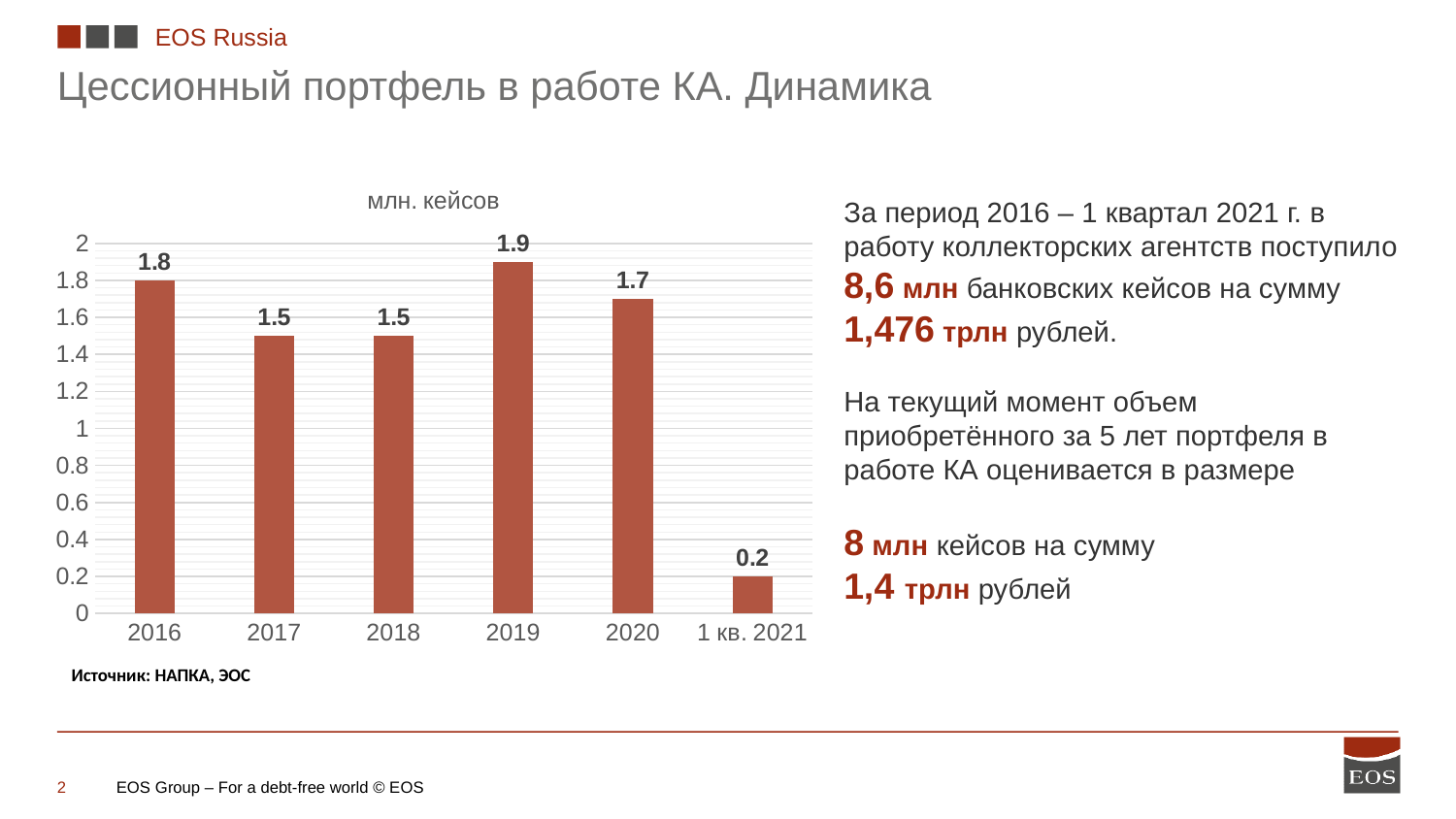
Is the value for 2020 greater or less than 1? greater Which category has the lowest value? 1 кв. 2021 How many categories are shown on the x axis? 6 What is the title of the chart? млн. кейсов What is the difference between the values for 2019 and 2020? 0.2 What kind of chart is shown on the slide? bar chart Which category has the highest value? 2019 Which is larger, the value for 2016 or the value for 2017? 2016 Do the values rise or fall from 2018 to 2019? rise What is the value for 1 кв. 2021? 0.2 What is the value for 2016? 1.8 What is the value for 2019? 1.9